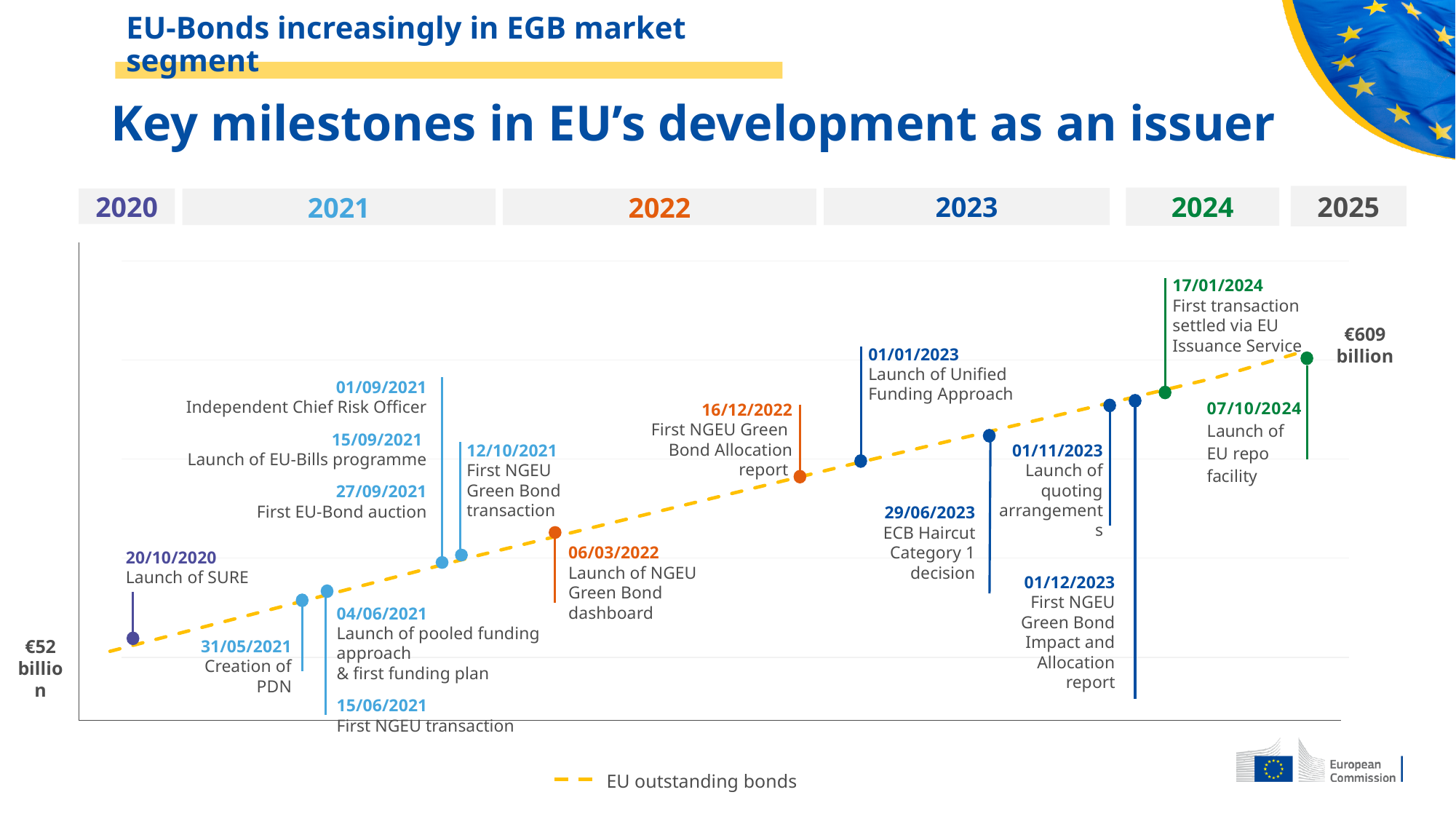
Which is larger, EU outstanding bonds in 2020 or in 2025? 2025 What is the value of EU outstanding bonds at the start of the timeline in 2020? €52 billion By how much did EU outstanding bonds grow between the €52 billion starting point and the €609 billion end point? €557 billion Do EU outstanding bonds rise or fall along the timeline from 2020 to 2025? rise How many years are shown across the top of the timeline? 6 How many series does the legend list? 1 On what date was the launch of the EU repo facility? 07/10/2024 What kind of chart is shown on the slide? line chart (timeline) What is the legend entry for the dashed line? EU outstanding bonds What is the value of EU outstanding bonds at the end of the timeline in 2025? €609 billion On what date was the first NGEU transaction? 15/06/2021 Which milestone is dated 20/10/2020? Launch of SURE